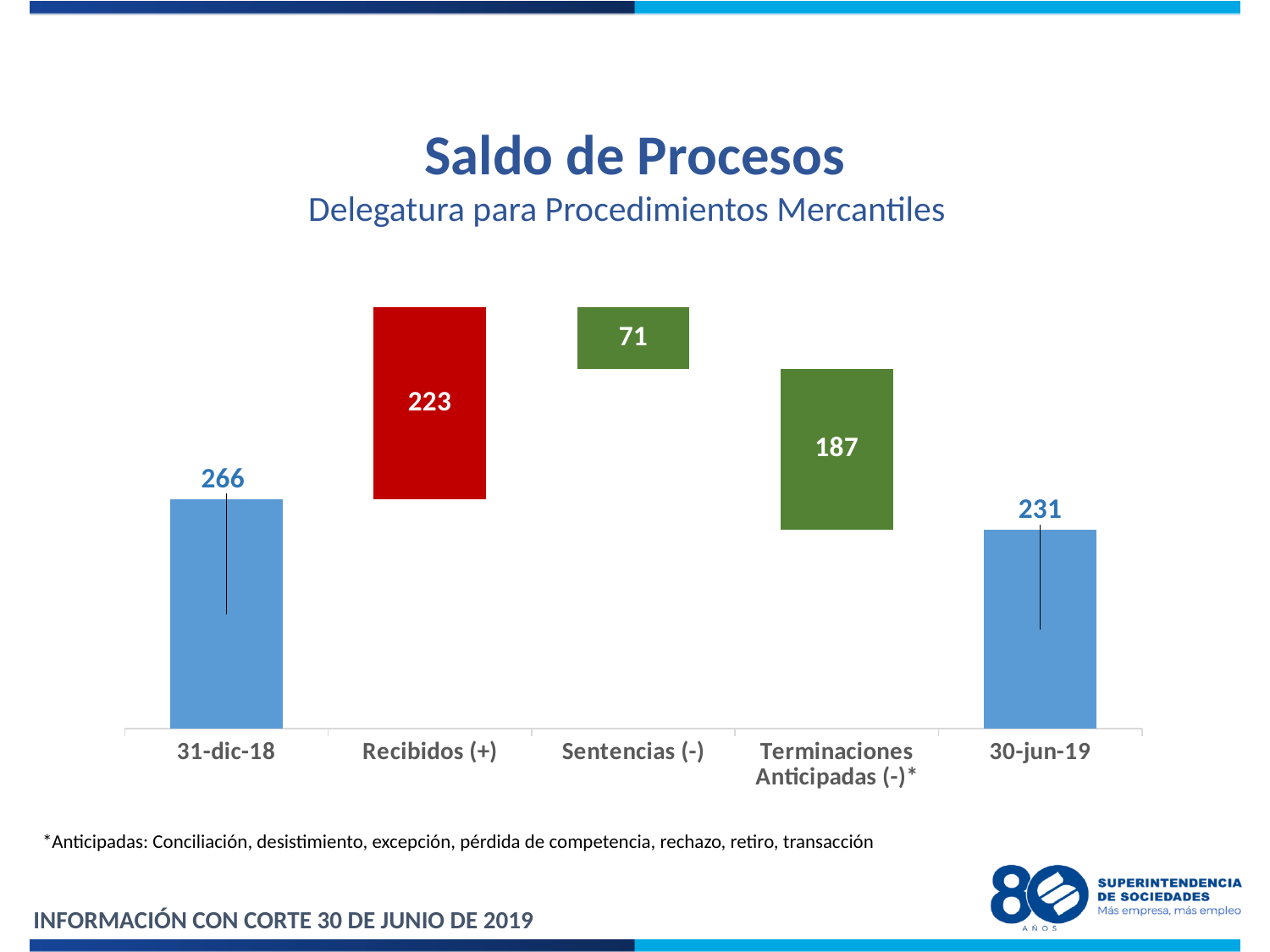
How many categories are shown on the x axis? 5 Which is larger, the value for Recibidos (+) or the value for Terminaciones Anticipadas (-)*? Recibidos (+) Which category has the highest value? 31-dic-18 What is the value shown for Terminaciones Anticipadas (-)*? 187 What is the value shown for 30-jun-19? 231 What is the value shown for Sentencias (-)? 71 What is the difference between the value for 31-dic-18 and the value for 30-jun-19? 35 What is the difference between the value for Terminaciones Anticipadas (-)* and the value for Sentencias (-)? 116 What is the value shown for 31-dic-18? 266 What is the title of the chart? Saldo de Procesos What is the value shown for Recibidos (+)? 223 Which category has the lowest value? Sentencias (-)